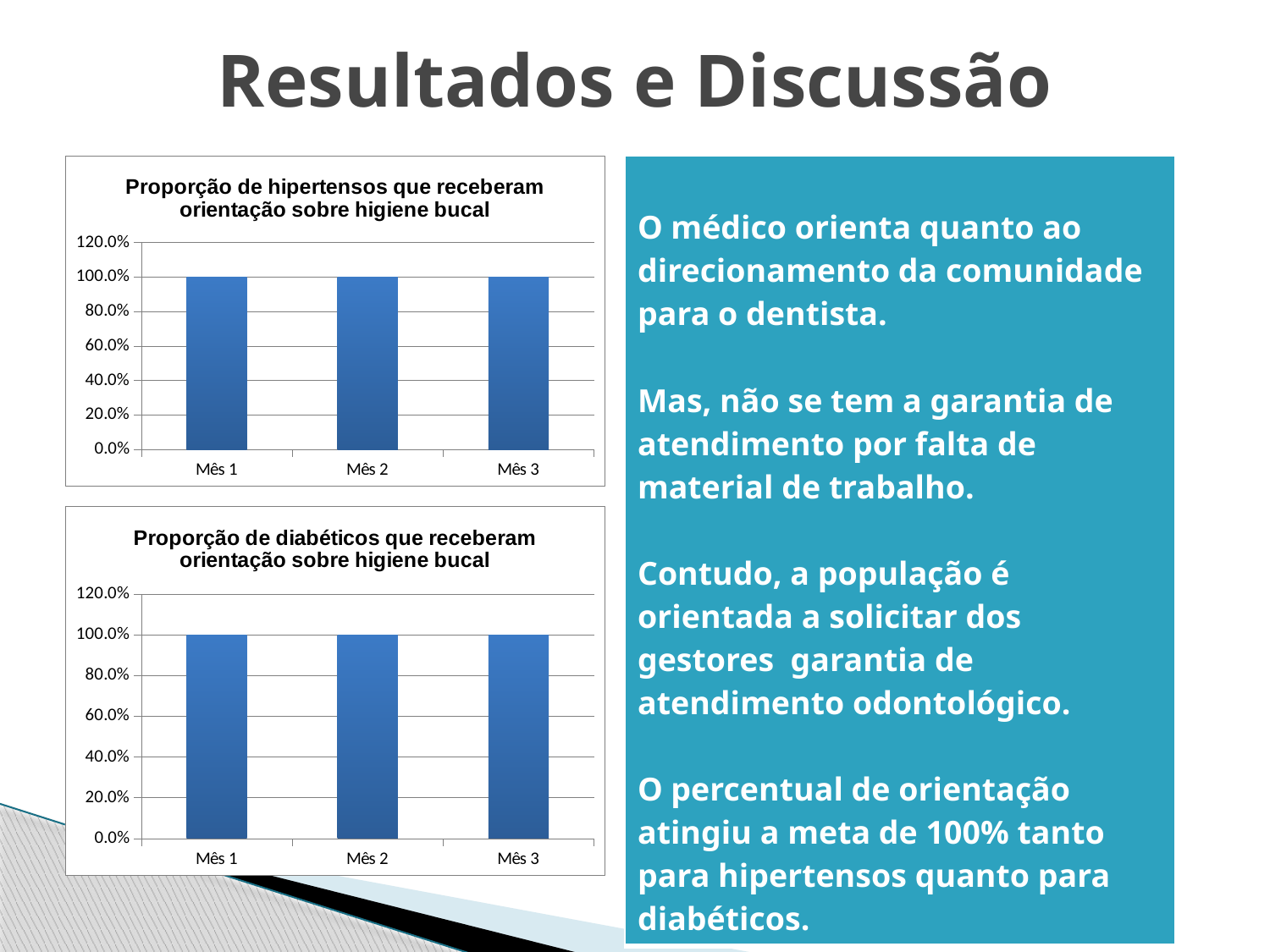
In the bottom chart, 'Proporção de diabéticos que receberam orientação sobre higiene bucal', what is the value for Mês 2? 100.0% How many categories are shown on the x axis of the top chart, 'Proporção de hipertensos que receberam orientação sobre higiene bucal'? 3 In the top chart, 'Proporção de hipertensos que receberam orientação sobre higiene bucal', what is the value for Mês 1? 100.0% In the bottom chart, 'Proporção de diabéticos que receberam orientação sobre higiene bucal', what is the value for Mês 3? 100.0% What is the title of the bottom chart on the slide? Proporção de diabéticos que receberam orientação sobre higiene bucal How many bars are plotted in the bottom chart, 'Proporção de diabéticos que receberam orientação sobre higiene bucal'? 3 In the top chart, 'Proporção de hipertensos que receberam orientação sobre higiene bucal', what is the value for Mês 2? 100.0% In the bottom chart, 'Proporção de diabéticos que receberam orientação sobre higiene bucal', is the value for Mês 1 greater or less than 60.0%? greater In the top chart, 'Proporção de hipertensos que receberam orientação sobre higiene bucal', what is the difference between the values for Mês 1 and Mês 3? 0.0% In the bottom chart, 'Proporção de diabéticos que receberam orientação sobre higiene bucal', do the values rise, fall or stay the same from Mês 1 to Mês 3? Stay the same What kind of chart is the top chart, 'Proporção de hipertensos que receberam orientação sobre higiene bucal'? Bar chart In the top chart, 'Proporção de hipertensos que receberam orientação sobre higiene bucal', is the value for Mês 3 greater or less than 80.0%? greater